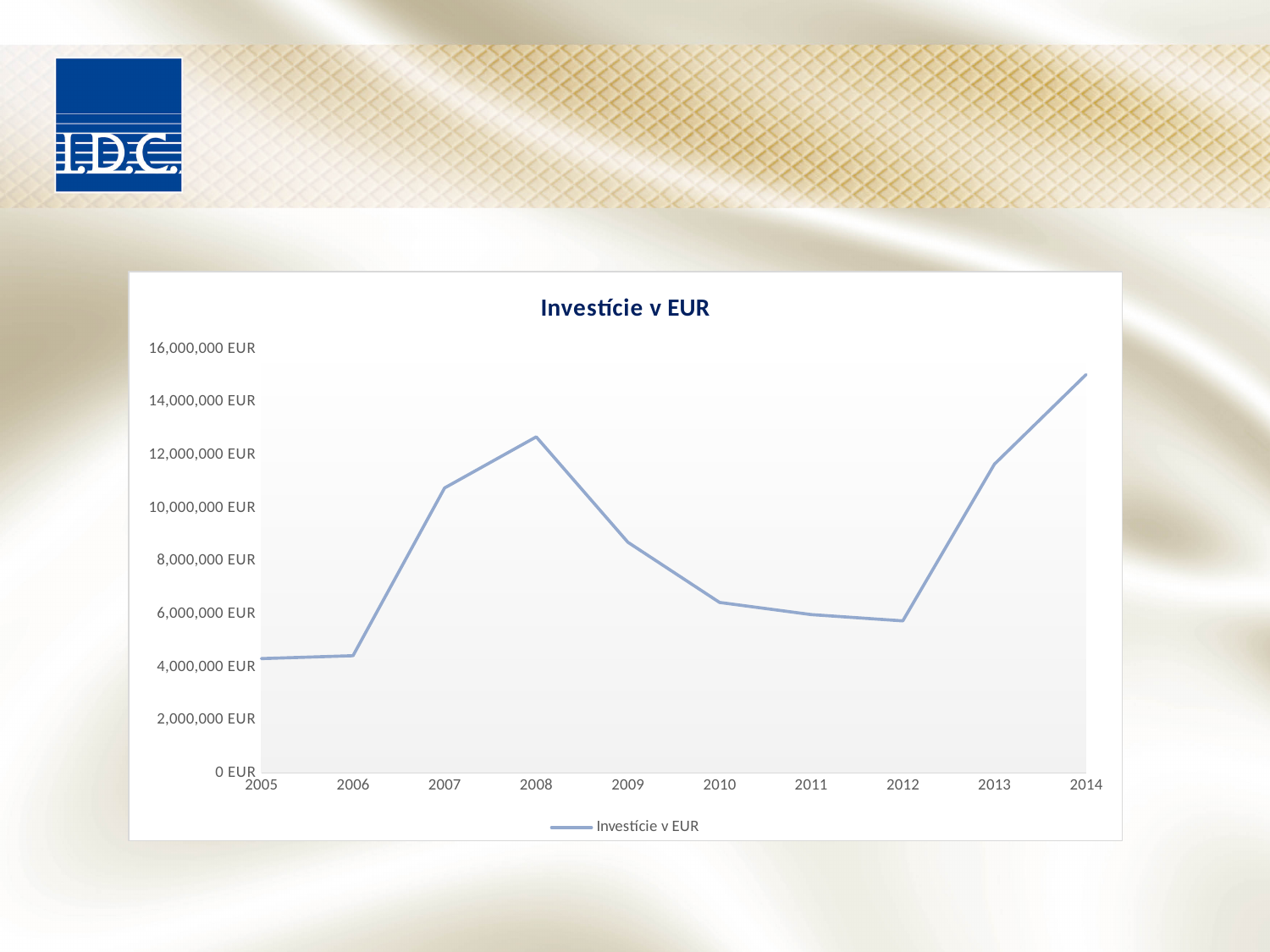
What is the title of the chart? Investície v EUR Which year has the larger value, 2007 or 2010? 2007 Is the value for 2009 greater or less than 10,000,000 EUR? less Which year has the highest value in the chart? 2014 Do the values rise or fall from 2012 to 2014? rise Do the values rise or fall from 2008 to 2012? fall How many years are plotted along the x axis of the chart? 10 Is the value for 2014 greater or less than 14,000,000 EUR? greater How many series does the legend of the chart list? 1 What kind of chart is shown on the slide? line chart Is the value for 2008 greater or less than 12,000,000 EUR? greater